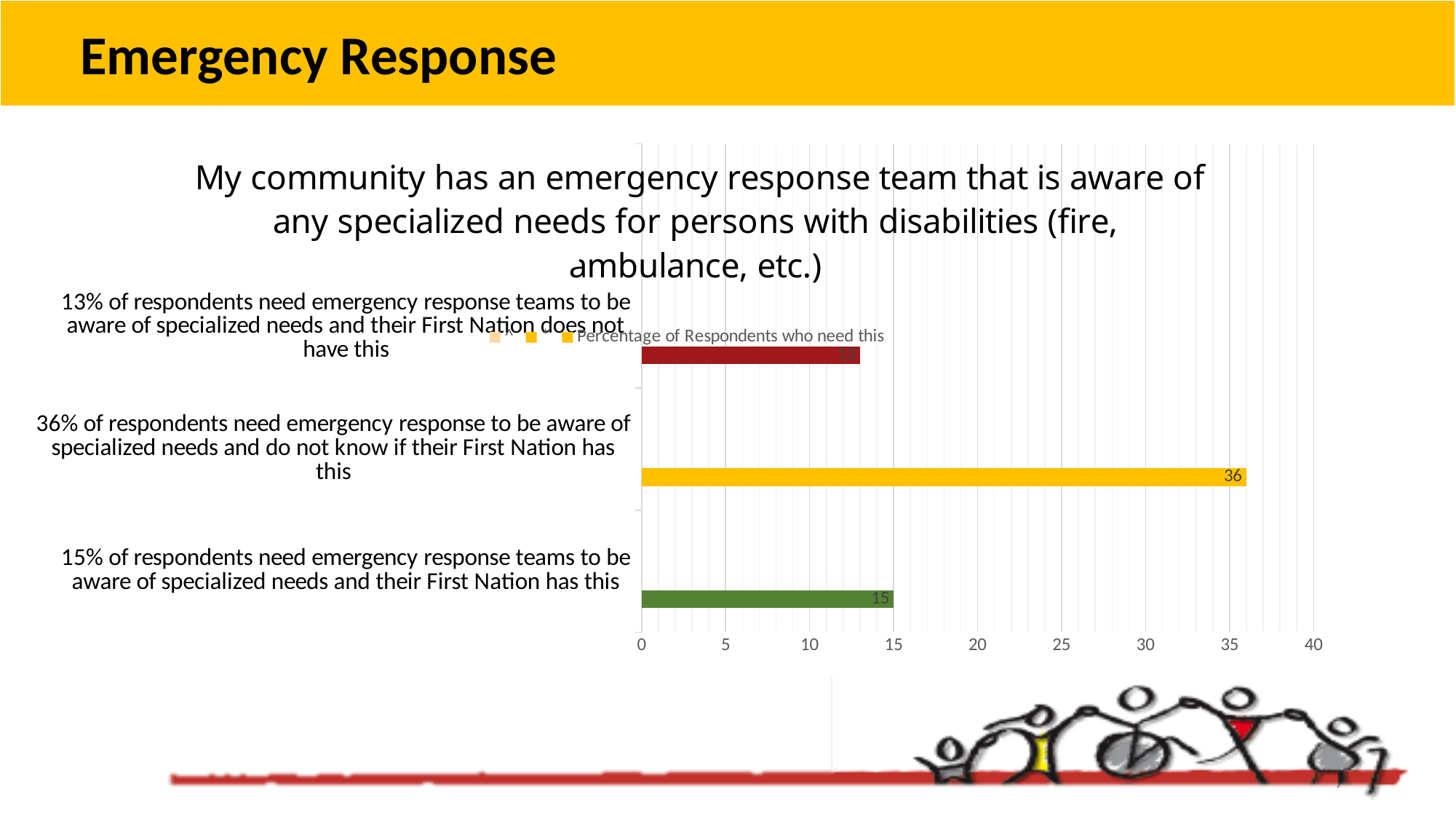
What is the value of the bar for respondents whose First Nation does not have an emergency response team aware of specialized needs? 13 Which category has the lowest value? 13% of respondents need emergency response teams to be aware of specialized needs and their First Nation does not have this What series name is shown in the chart legend? Percentage of Respondents who need this Which category has the highest value? 36% of respondents need emergency response to be aware of specialized needs and do not know if their First Nation has this What is the difference between the value for respondents who do not know if their First Nation has this and the value for respondents whose First Nation has this? 21 Is the value for respondents who do not know if their First Nation has this greater or less than 30? greater What is the value of the bar for respondents who do not know if their First Nation has this? 36 What is the value of the bar for respondents whose First Nation has this? 15 How many categories (bars) are shown in the chart? 3 What is the title of the chart? My community has an emergency response team that is aware of any specialized needs for persons with disabilities (fire, ambulance, etc.) What type of chart is shown on the slide? bar chart Which is larger: the value for respondents whose First Nation has this or the value for respondents whose First Nation does not have this? their First Nation has this (15)